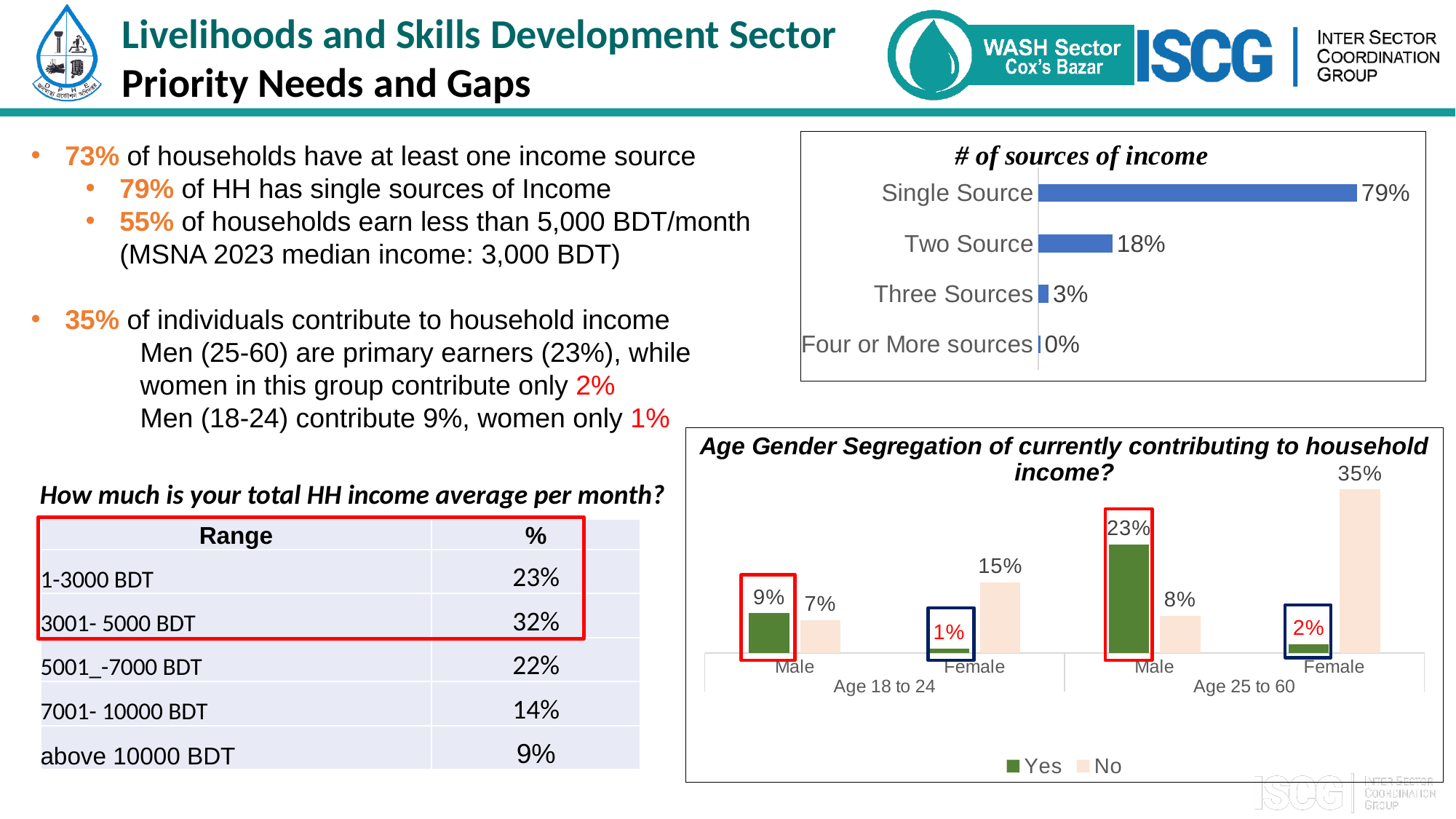
In the 'Age Gender Segregation' chart, what is the difference between the No values for Female in Age 25 to 60 and Female in Age 18 to 24? 20% In the 'Age Gender Segregation' chart, what is the Yes value for Female in Age 18 to 24? 1% In the 'Age Gender Segregation' chart, how many series does the legend list? 2 In the '# of sources of income' chart, what percentage of households have a single source of income? 79% In the 'Age Gender Segregation' chart, what is the No value for Female in Age 25 to 60? 35% In the '# of sources of income' chart, what is the difference between Single Source and Two Source? 61% In the '# of sources of income' chart, which category has the lowest value? Four or More sources In the '# of sources of income' chart, how many categories are shown? 4 What type of chart is the '# of sources of income' chart? Bar chart In the '# of sources of income' chart, what is the value for Two Source? 18% In the 'Age Gender Segregation' chart, which is larger for Male in Age 18 to 24: Yes or No? Yes In the 'Age Gender Segregation' chart, what is the Yes value for Male in Age 25 to 60? 23%